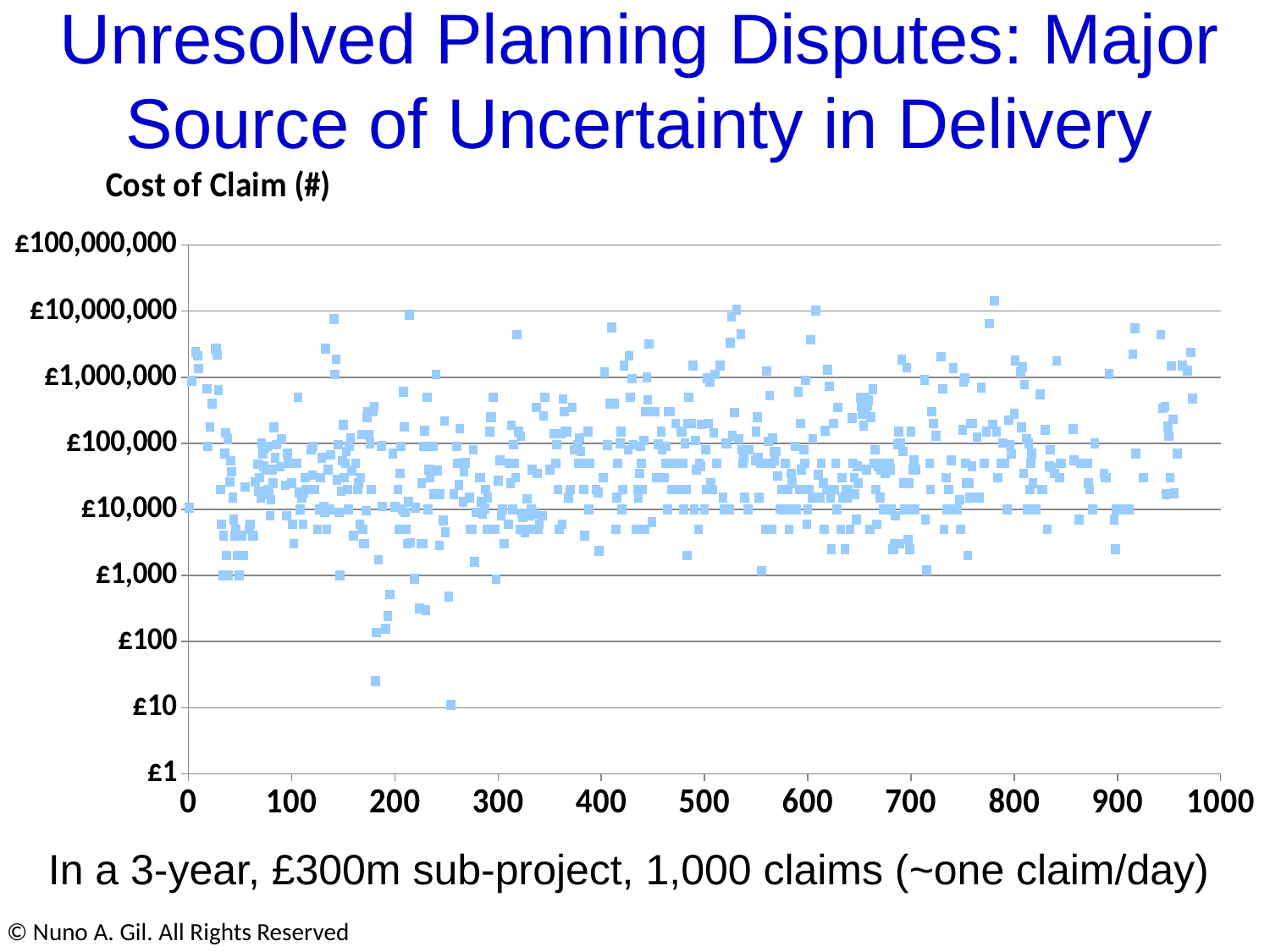
What is the highest value labelled on the vertical axis? £100,000,000 Is the highest plotted point on the chart greater or less than £10,000,000? greater Is the lowest plotted point on the chart greater or less than £1? greater What kind of chart is shown on the slide? scatter chart Is the highest plotted point on the chart greater or less than £100,000,000? less What is the title of the vertical axis of the chart? Cost of Claim (#)